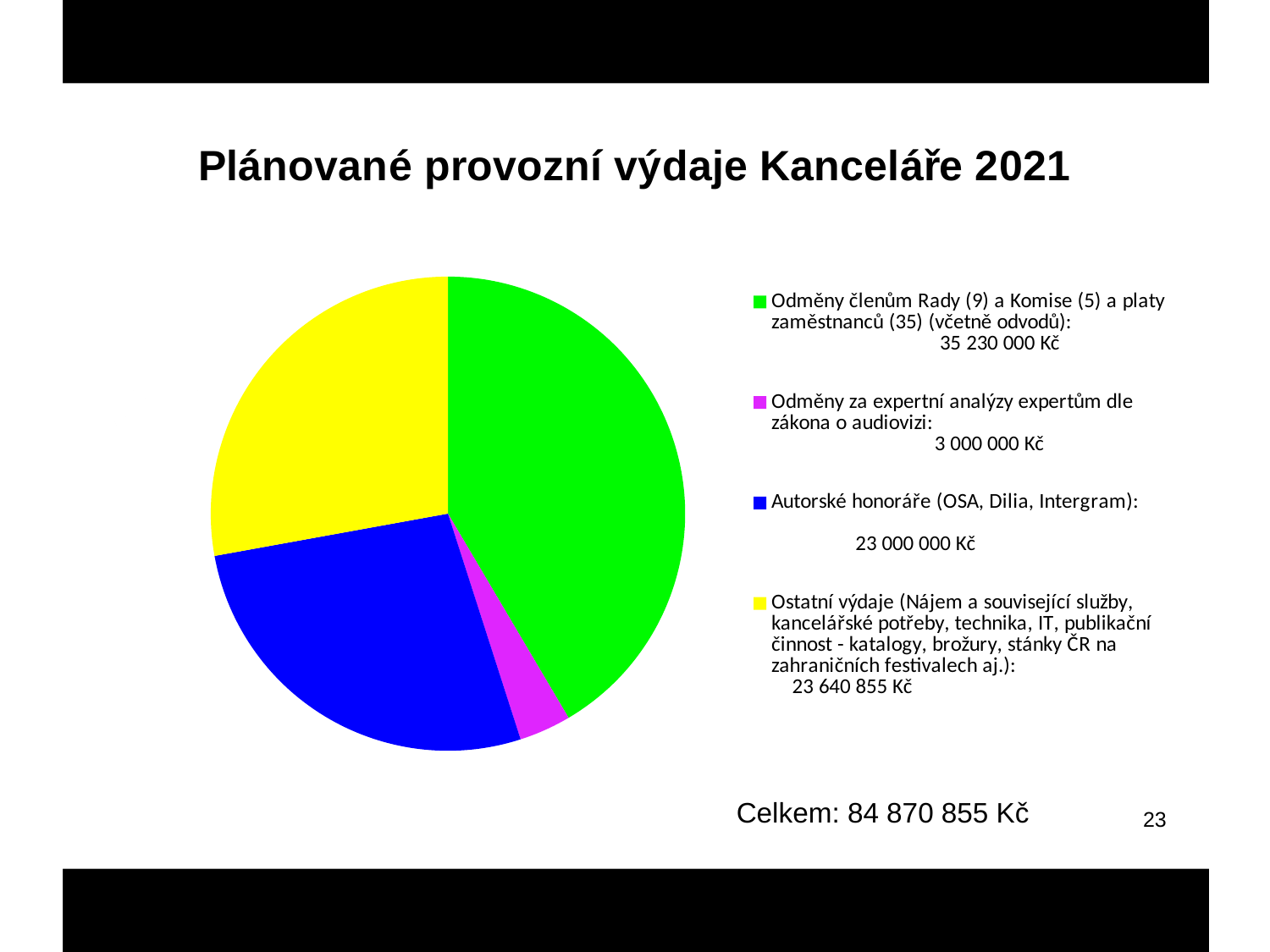
What is the planned amount for Autorské honoráře (OSA, Dilia, Intergram)? 23 000 000 Kč How many slices does the pie chart have? 4 What type of chart is shown on the slide? pie chart Which is larger: the amount for Autorské honoráře or the amount for Odměny za expertní analýzy? Autorské honoráře What is the planned amount for Ostatní výdaje? 23 640 855 Kč What is the total of all planned expenditures shown on the slide? 84 870 855 Kč What is the difference between the amount for Odměny členům Rady a Komise a platy zaměstnanců and the amount for Autorské honoráře? 12 230 000 Kč What is the planned amount for Odměny členům Rady (9) a Komise (5) a platy zaměstnanců (35) (včetně odvodů)? 35 230 000 Kč Which category has the largest planned expenditure? Odměny členům Rady (9) a Komise (5) a platy zaměstnanců (35) (včetně odvodů) Which category has the smallest planned expenditure? Odměny za expertní analýzy expertům dle zákona o audiovizi What is the title of the chart on the slide? Plánované provozní výdaje Kanceláře 2021 What is the planned amount for Odměny za expertní analýzy expertům dle zákona o audiovizi? 3 000 000 Kč